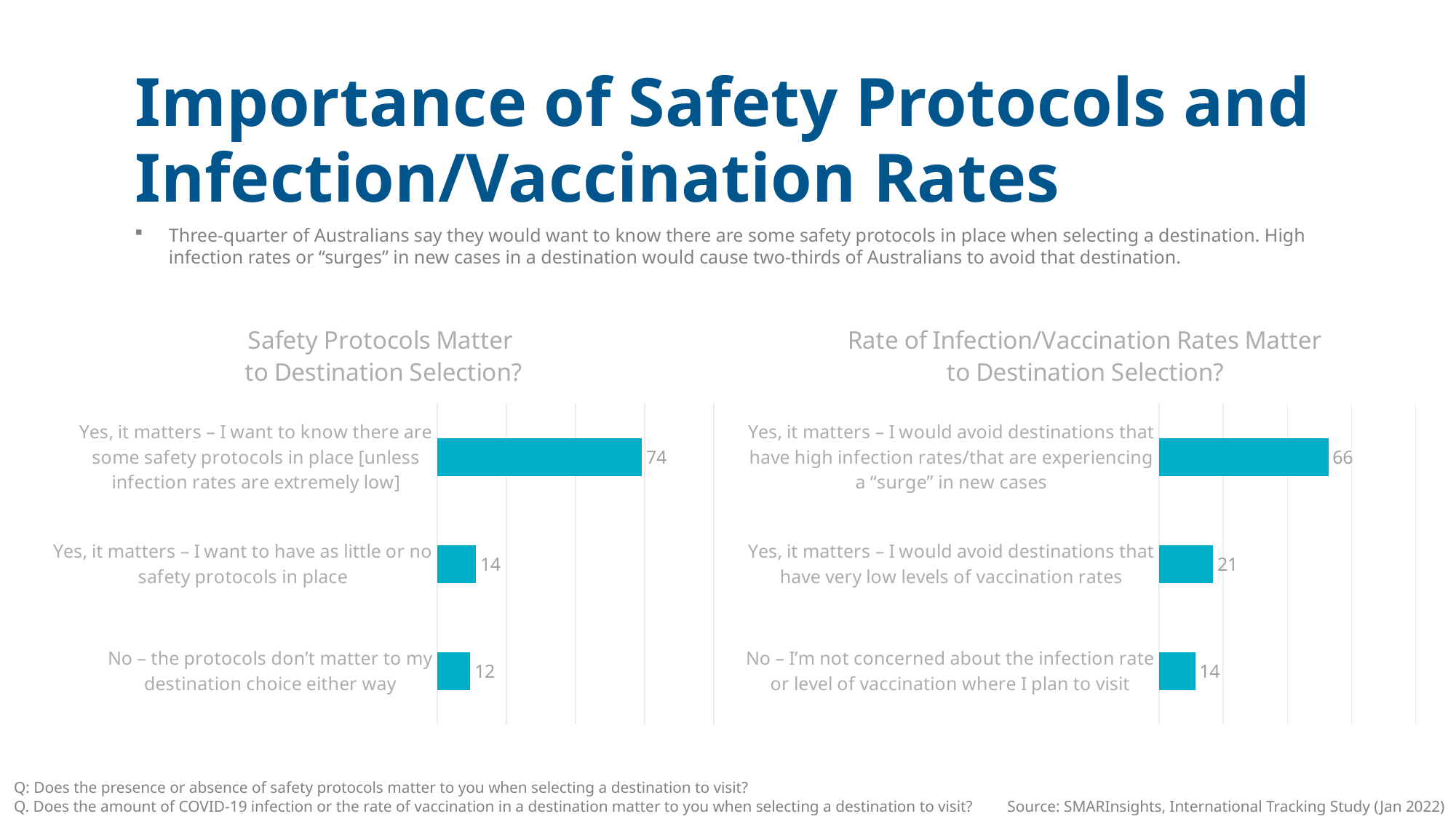
In the 'Safety Protocols Matter to Destination Selection?' chart, what is the value for 'No – the protocols don't matter to my destination choice either way'? 12 In the 'Rate of Infection/Vaccination Rates Matter to Destination Selection?' chart, which category has the lowest value? No – I'm not concerned about the infection rate or level of vaccination where I plan to visit What is the title of the chart on the right side of the slide? Rate of Infection/Vaccination Rates Matter to Destination Selection? In the 'Safety Protocols Matter to Destination Selection?' chart, what is the difference between the values for 'Yes, it matters – I want to know there are some safety protocols in place' and 'No – the protocols don't matter'? 62 Which is larger: the top bar in the 'Safety Protocols Matter' chart or the top bar in the 'Rate of Infection/Vaccination Rates Matter' chart? The top bar in the 'Safety Protocols Matter' chart (74) What type of chart is the 'Safety Protocols Matter to Destination Selection?' chart? Bar chart In the 'Rate of Infection/Vaccination Rates Matter to Destination Selection?' chart, what is the value for 'Yes, it matters – I would avoid destinations that have very low levels of vaccination rates'? 21 In the 'Rate of Infection/Vaccination Rates Matter to Destination Selection?' chart, what is the value for 'No – I'm not concerned about the infection rate or level of vaccination where I plan to visit'? 14 In the 'Safety Protocols Matter to Destination Selection?' chart, which category has the highest value? Yes, it matters – I want to know there are some safety protocols in place [unless infection rates are extremely low] In the 'Safety Protocols Matter to Destination Selection?' chart, what is the value for 'Yes, it matters – I want to know there are some safety protocols in place'? 74 How many categories are shown in the 'Rate of Infection/Vaccination Rates Matter to Destination Selection?' chart? 3 In the 'Rate of Infection/Vaccination Rates Matter to Destination Selection?' chart, what is the difference between the values for 'Yes, it matters – I would avoid destinations that have high infection rates' and 'Yes, it matters – I would avoid destinations that have very low levels of vaccination rates'? 45